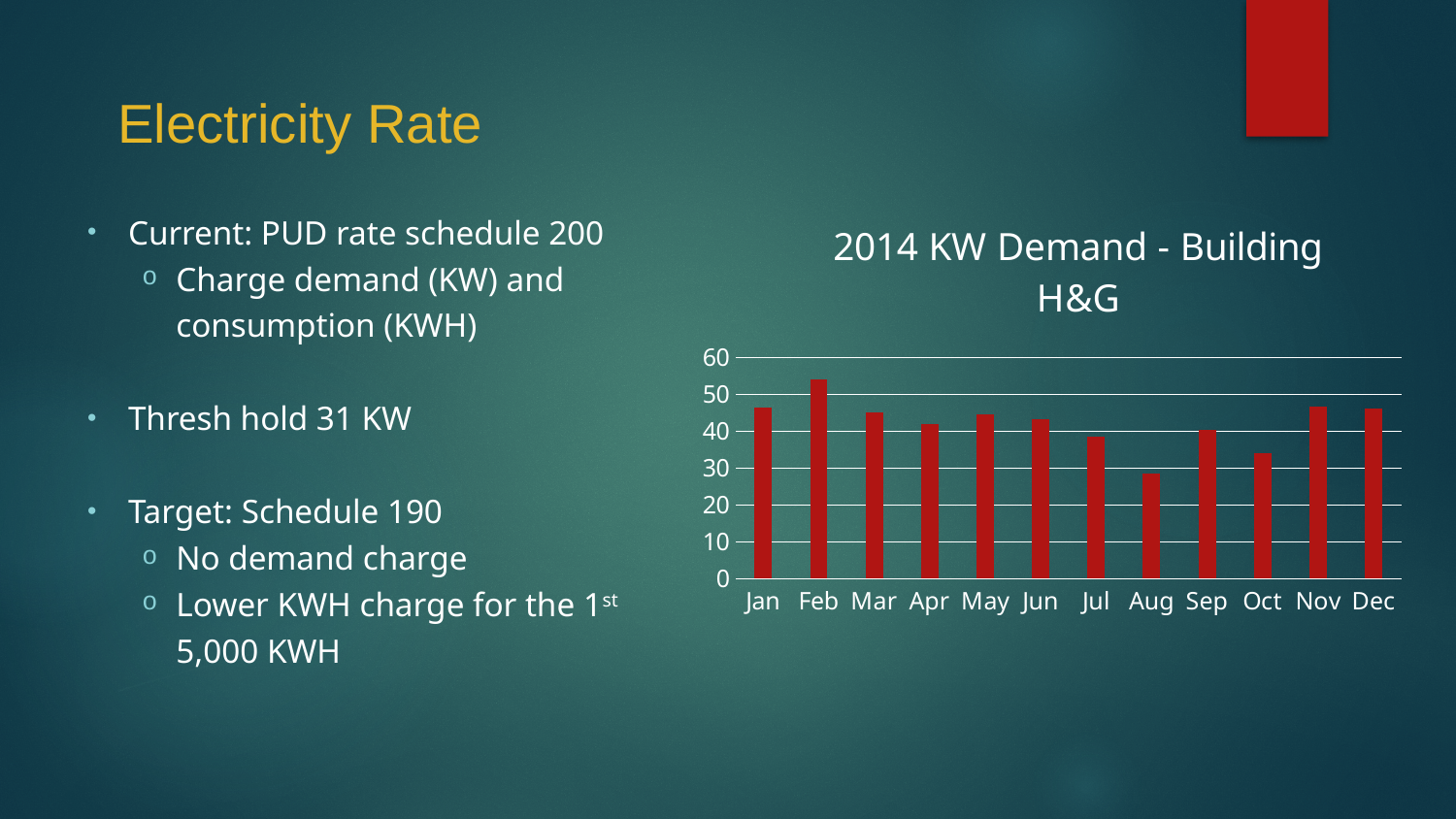
What is the title of the chart? 2014 KW Demand - Building H&G Is the value for Jan greater or less than 40? greater What kind of chart is shown on the slide? bar chart Which month has the lowest KW demand? Aug Is the value for Feb greater or less than 50? greater Which is larger, the value for Aug or the value for Sep? Sep Which month has the highest KW demand? Feb How many months are plotted on the chart? 12 Is the value for Aug greater or less than 30? less Do the values rise or fall from Jun to Aug? fall Which is larger, the value for Apr or the value for Oct? Apr